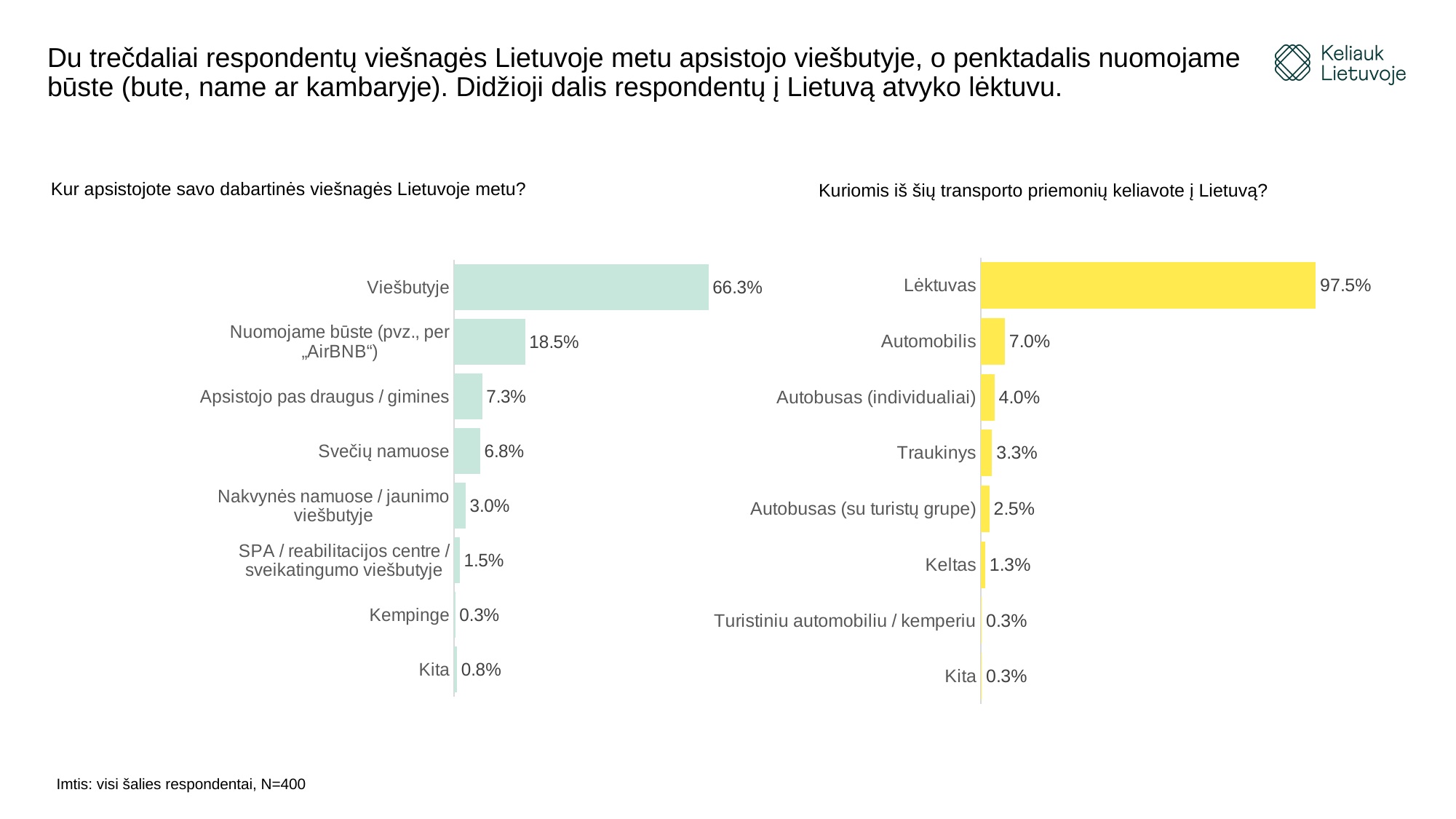
In the right chart (Kuriomis iš šių transporto priemonių keliavote į Lietuvą?), what is the value for Automobilis? 7.0% In the right chart, which category has the highest value? Lėktuvas What kind of chart is the right chart? Bar chart In the left chart, which category has the highest value? Viešbutyje In the left chart, which is larger: Apsistojo pas draugus / gimines or Svečių namuose? Apsistojo pas draugus / gimines In the left chart, which category has the lowest value? Kempinge In the right chart, which is larger: Traukinys or Autobusas (su turistų grupe)? Traukinys In the left chart, what is the difference between Viešbutyje and Nuomojame būste (pvz., per „AirBNB“)? 47.8% How many categories does the right chart show? 8 How many categories does the left chart show? 8 In the right chart, what is the difference between Lėktuvas and Automobilis? 90.5% In the left chart (Kur apsistojote savo dabartinės viešnagės Lietuvoje metu?), what is the value for Viešbutyje? 66.3%